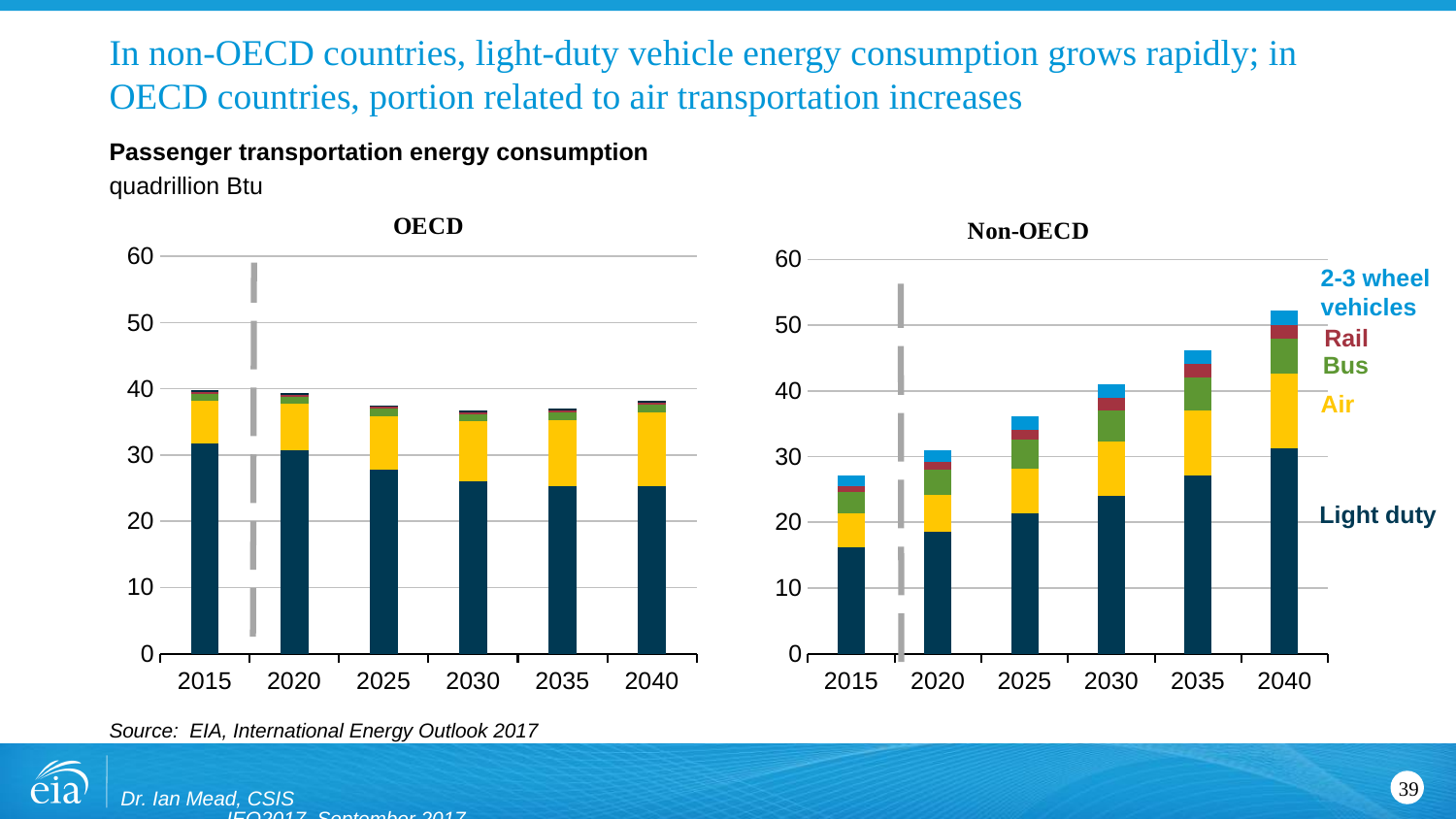
Which is larger in 2040: the total for the OECD chart or the total for the Non-OECD chart? Non-OECD In the Non-OECD chart, is the total for 2035 greater or less than 40? greater In the Non-OECD chart, do total values rise or fall from 2015 to 2040? rise How many series does the legend list for the passenger transportation energy consumption charts? 5 In the Non-OECD chart, is the total for 2040 greater or less than 50? greater In the OECD chart, is the total for 2040 greater or less than 40? less What kind of chart is the OECD chart? stacked bar chart What unit is used for the values on both charts? quadrillion Btu In the Non-OECD chart, which year has the lowest total passenger transportation energy consumption? 2015 How many years are shown on the x axis of the Non-OECD chart? 6 In the Non-OECD chart, which year has the highest total passenger transportation energy consumption? 2040